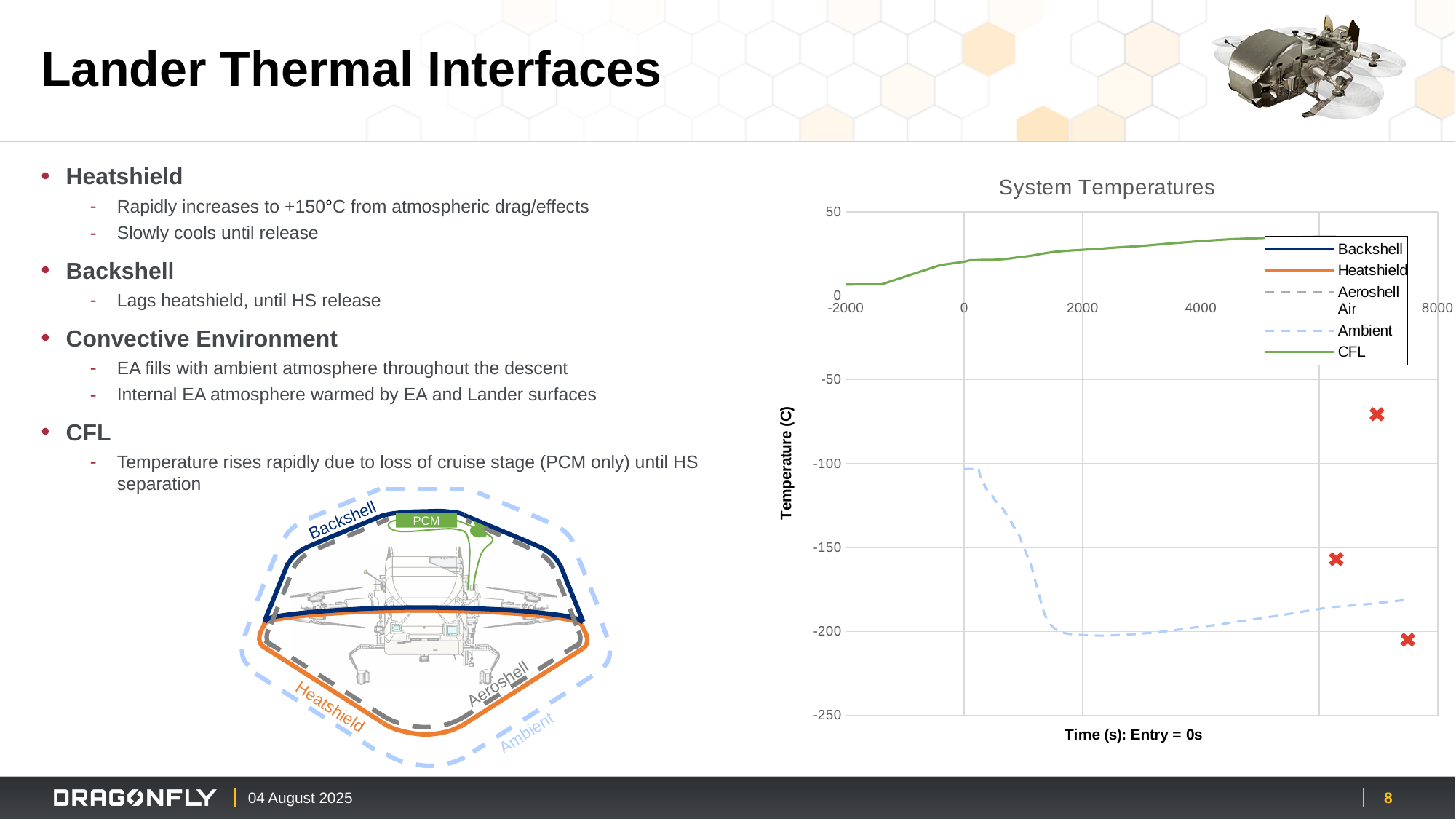
What is the lowest tick value shown on the vertical axis of the System Temperatures chart? -250 What is the label of the vertical axis of the System Temperatures chart? Temperature (C) In the System Temperatures chart, is the CFL value at time 0 greater or less than 0? greater What type of chart is shown under the title "System Temperatures"? line chart In the System Temperatures chart, does the CFL temperature rise or fall as time increases? rise In the System Temperatures chart, is the Ambient value at time 2000 greater or less than -150? less In the System Temperatures chart, is the CFL value at time 4000 greater or less than 50? less In the System Temperatures chart, which series has the higher value at time 2000, CFL or Ambient? CFL What is the title of the chart on the slide? System Temperatures In the System Temperatures chart, does the Ambient temperature rise or fall between time 0 and time 2000? fall How many series does the legend of the System Temperatures chart list? 5